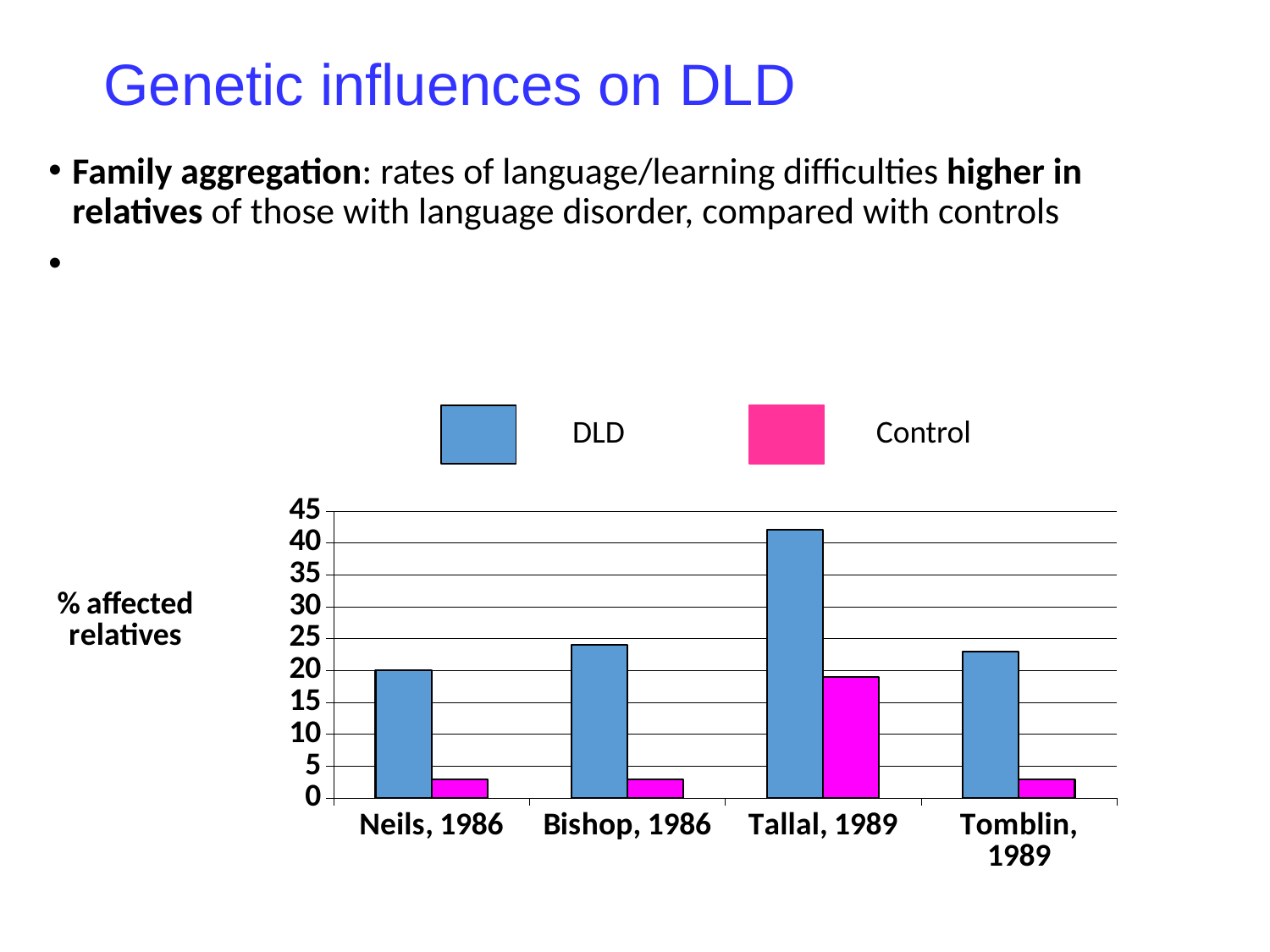
Is the DLD value for Bishop, 1986 greater or less than 20? greater Which study has the highest Control value in the chart? Tallal, 1989 Is the DLD value for Tallal, 1989 greater or less than 40? greater Which study has the lowest DLD value in the chart? Neils, 1986 What kind of chart is shown on the slide? bar chart Is the Control value for Neils, 1986 greater or less than 5? less What is the label on the vertical axis of the chart? % affected relatives How many series does the chart's legend list? 2 Which study has the highest DLD value in the chart? Tallal, 1989 How many studies (categories) are shown along the x axis of the chart? 4 What are the two series named in the chart's legend? DLD and Control Which is larger: the Control value for Tallal, 1989 or the Control value for Tomblin, 1989? Tallal, 1989